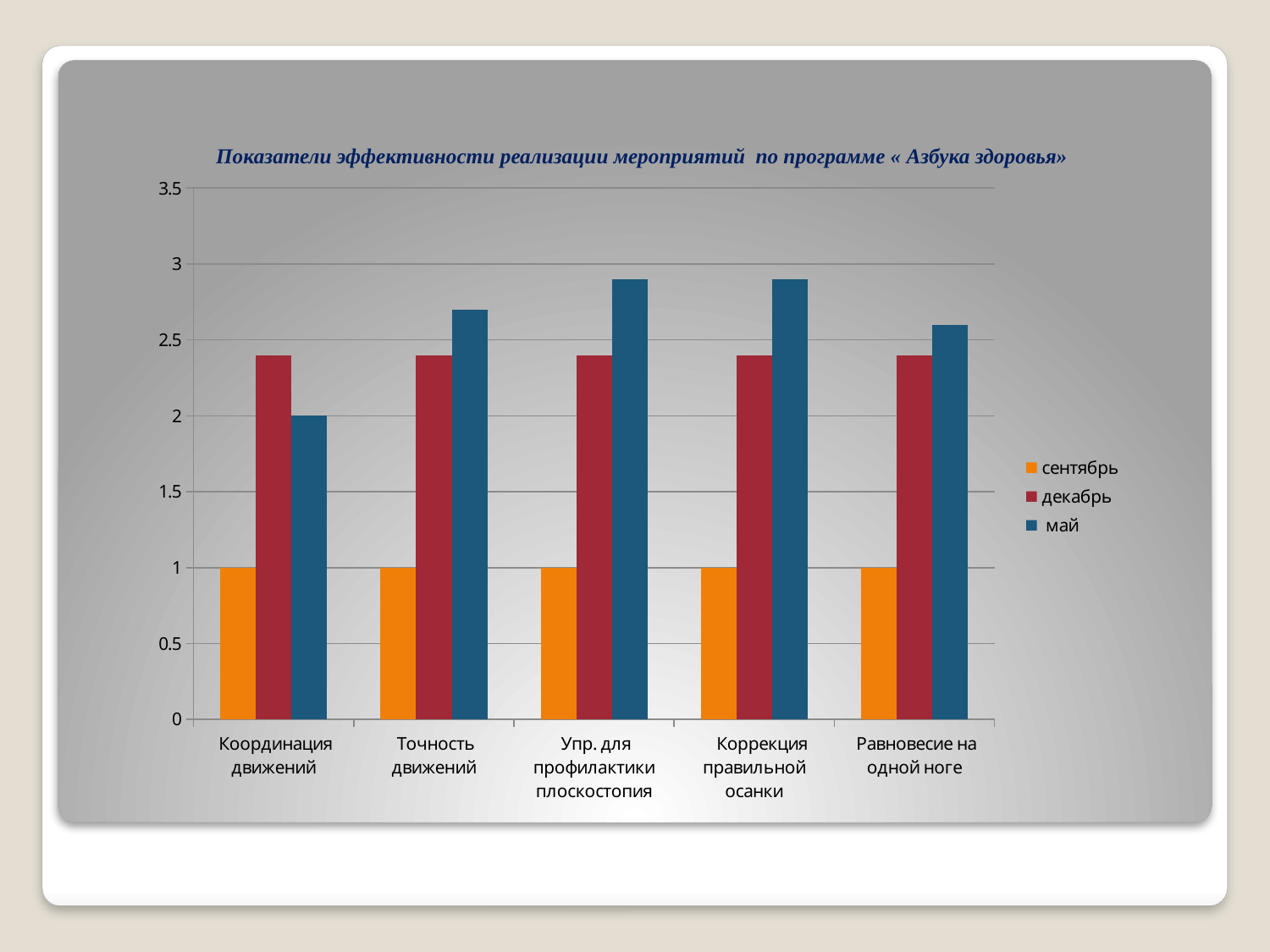
For май, which is larger: the value for Упр. для профилактики плоскостопия or the value for Равновесие на одной ноге? Упр. для профилактики плоскостопия Is the value for декабрь in the category Точность движений greater or less than 2? greater In the category Координация движений, which is larger: the value for декабрь or the value for май? декабрь How many series does the legend list? 3 Which series is shown in orange in the legend? сентябрь How many categories are shown on the x axis? 5 What kind of chart is shown on the slide? bar chart Is the value for май in the category Упр. для профилактики плоскостопия greater or less than 2.5? greater What is the value for май in the category Координация движений? 2 Which category has the lowest value for май? Координация движений What is the value for сентябрь in the category Координация движений? 1 What is the value for сентябрь in the category Равновесие на одной ноге? 1